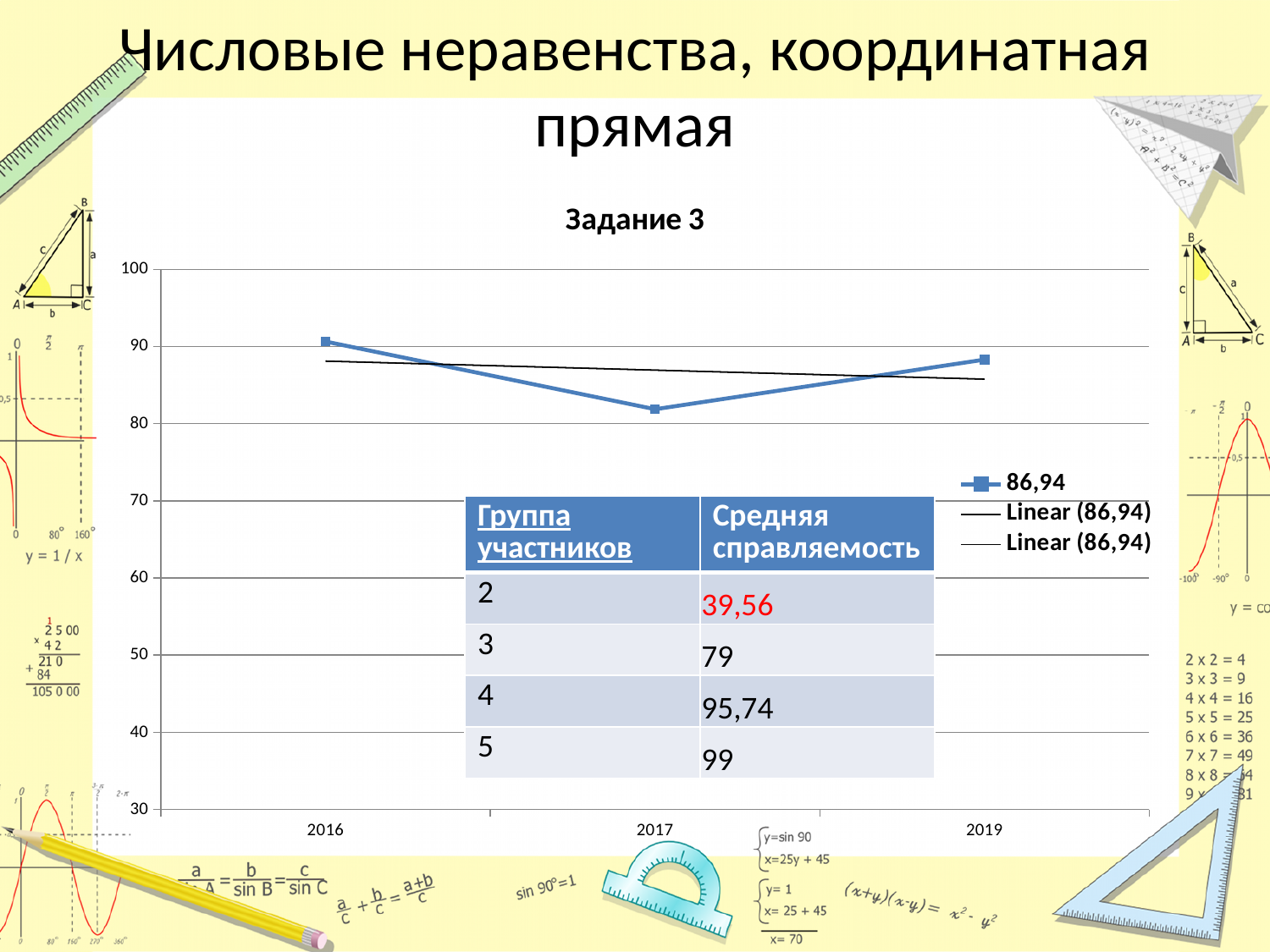
Does the blue line rise or fall from 2016 to 2017? fall Is the value for 2017 greater or less than 90? less Which is larger, the value for 2016 or the value for 2017? 2016 How many data points are plotted on the blue line? 3 What kind of chart is shown under the title "Задание 3"? line chart Is the value for 2017 greater or less than 80? greater What is the title of the chart? Задание 3 Which year has the highest value on the blue line? 2016 How many entries does the chart legend list? 3 Which year has the lowest value on the blue line? 2017 What is the name of the blue data series in the legend? 86,94 Is the value for 2019 greater or less than 90? less